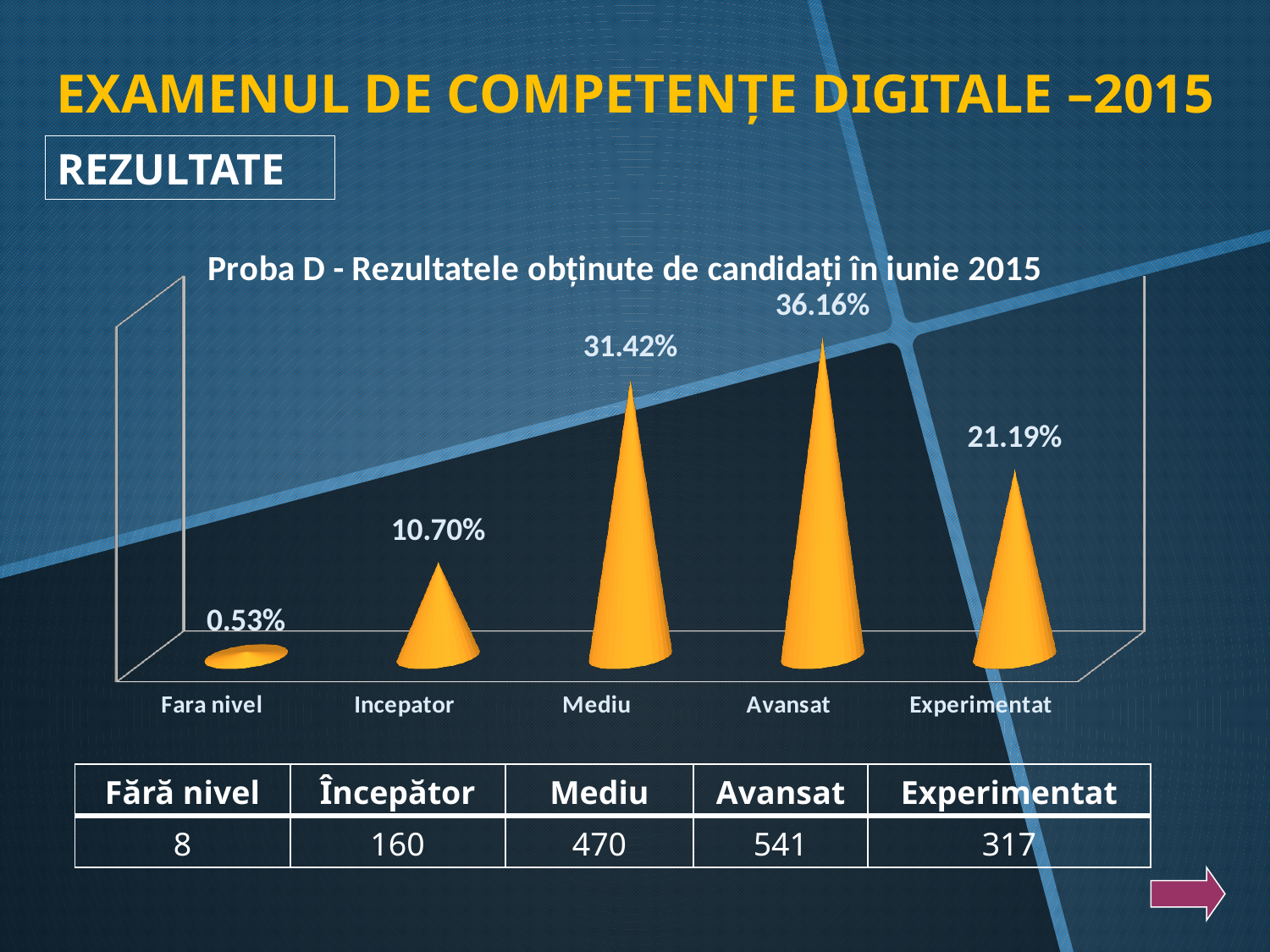
What is the difference between the values for Mediu and Experimentat? 10.23% What is the title of the chart? Proba D - Rezultatele obținute de candidați în iunie 2015 Which is larger, the value for Incepator or the value for Experimentat? Experimentat What kind of chart is shown on the slide? Bar chart What is the value shown for Experimentat? 21.19% What is the difference between the values for Avansat and Mediu? 4.74% What is the value shown for Fara nivel? 0.53% Which category has the lowest value? Fara nivel Which category has the highest value? Avansat How many categories are shown on the chart? 5 What is the value shown for Mediu? 31.42% What is the value shown for Incepator? 10.70%